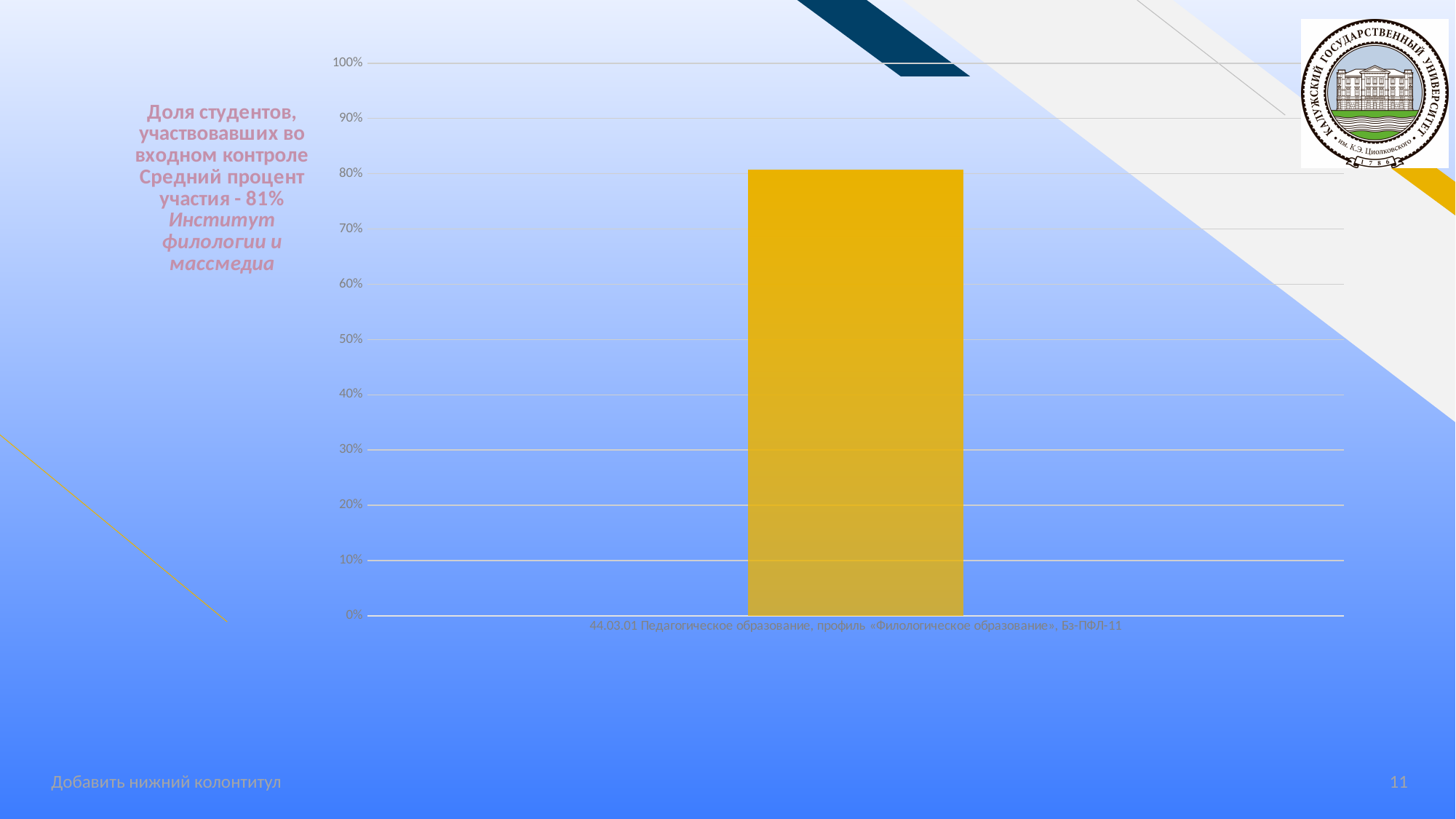
Is the value for 44.03.01 Педагогическое образование, профиль «Филологическое образование», Бз-ПФЛ-11 greater or less than 90%? less Is the value for 44.03.01 Педагогическое образование, профиль «Филологическое образование», Бз-ПФЛ-11 greater or less than 50%? greater What category label appears under the bar on the x axis? 44.03.01 Педагогическое образование, профиль «Филологическое образование», Бз-ПФЛ-11 What is the highest value shown on the vertical axis of the chart? 100% How many bars does the chart contain? 1 What colour is the bar in the chart? yellow Is the value for 44.03.01 Педагогическое образование, профиль «Филологическое образование», Бз-ПФЛ-11 greater or less than 70%? greater What kind of chart is shown on the slide? bar chart